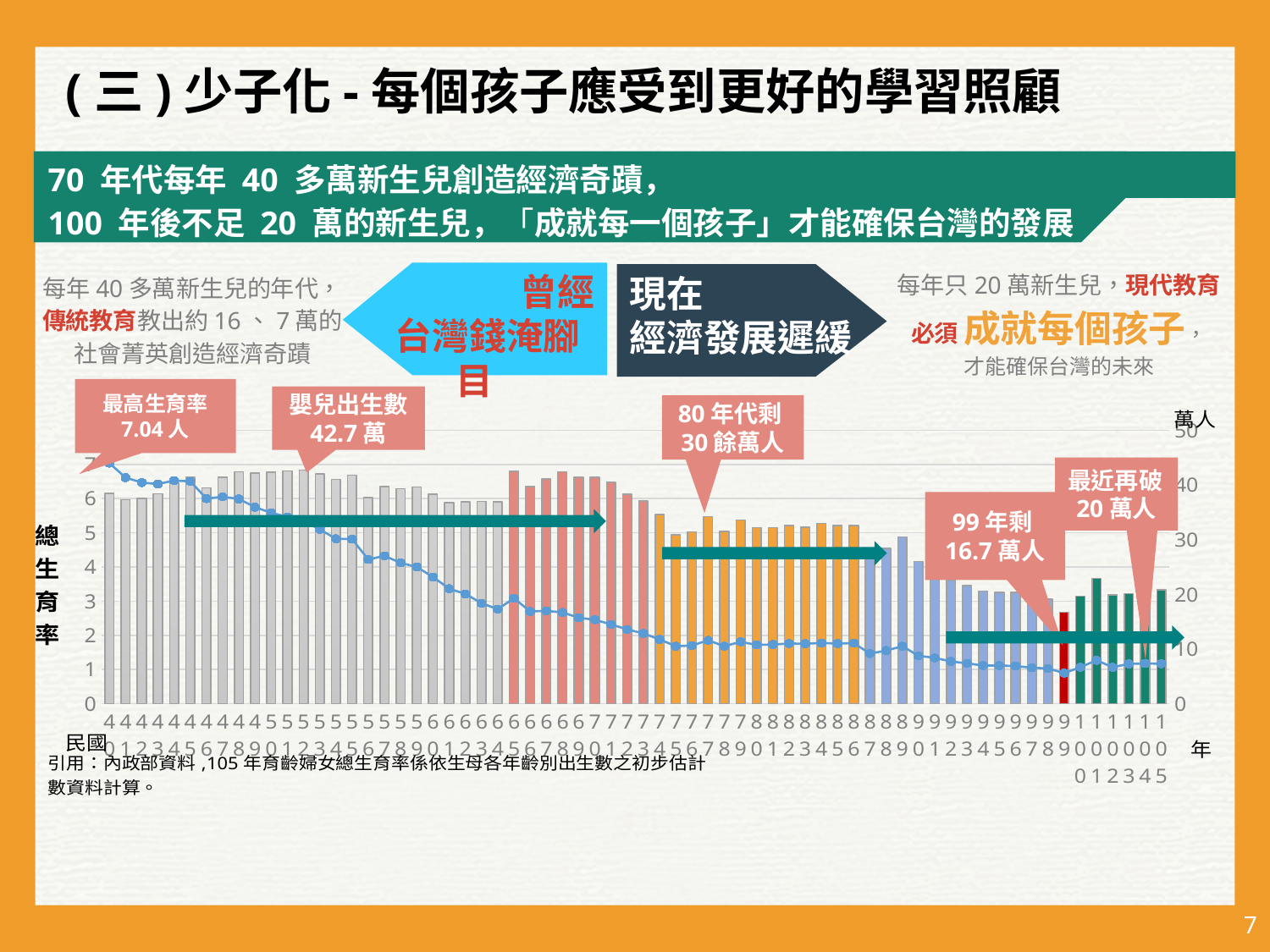
Is the total fertility rate in 民國 105 年 greater or less than 2? Less According to the callout, what was the peak number of infant births? 42.7 萬 What is the maximum value shown on the right vertical axis? 50 What is the highest total fertility rate shown in the callout on the chart? 7.04 人 Is the total fertility rate in 民國 40 年 greater or less than 6? Greater What unit is shown at the top of the right vertical axis? 萬人 According to the callout, how many births were there in 民國 99 年? 16.7 萬人 What kind of chart is shown on the slide? A combined bar and line chart What is the label of the left vertical axis? 總生育率 Is the number of births in 民國 99 年 greater or less than 20 萬人? Less According to the callout, roughly how many births remained in the 80 年代? 30 餘萬人 Does the total fertility rate line rise or fall from 民國 40 年 to 民國 105 年? Fall